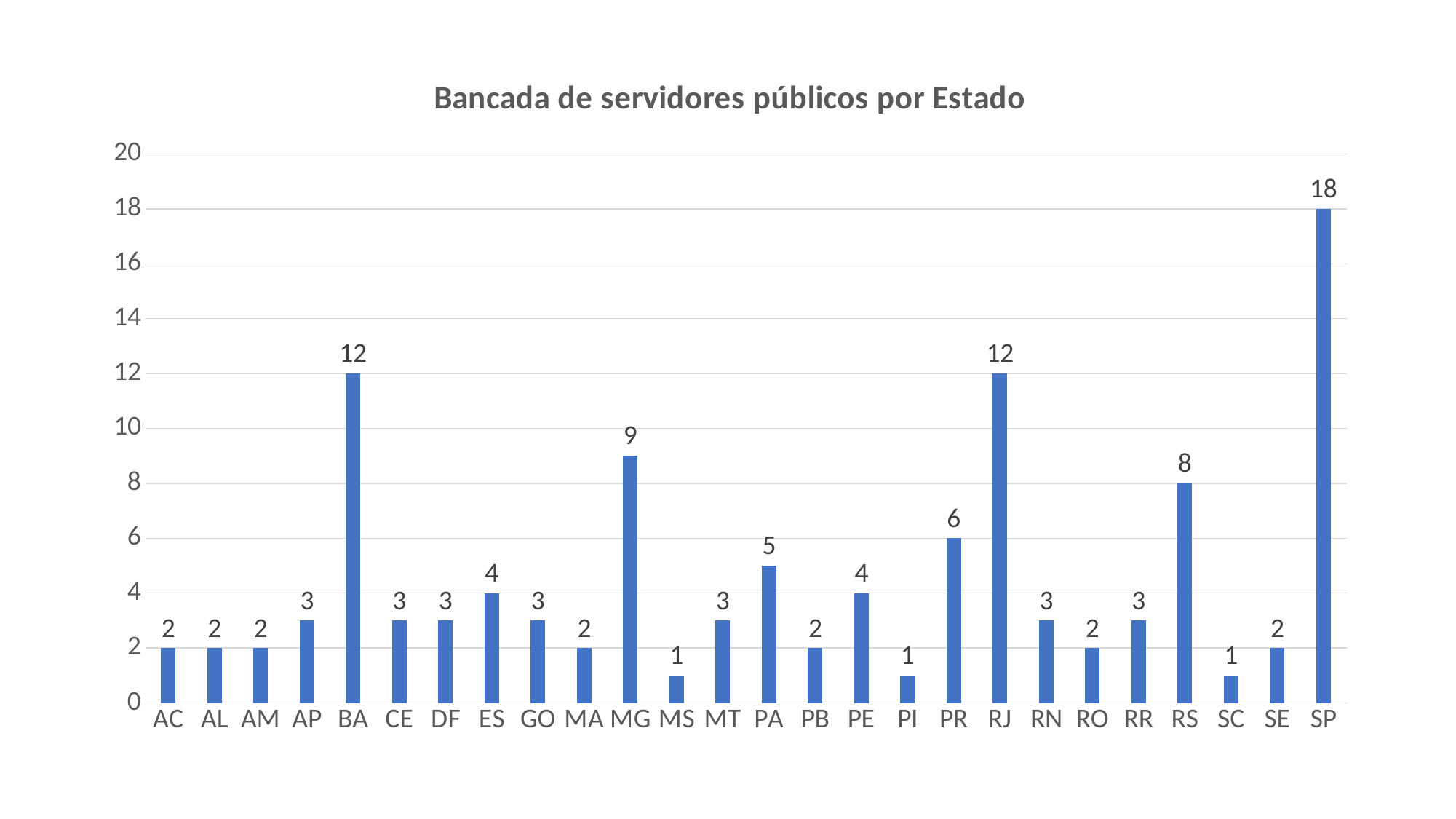
What is the value for PA? 5 What is the value for MG? 9 What is the value for RS? 8 Which has a larger value, RS or MG? MG Which state has the highest value? SP What is the difference between the values for SP and RJ? 6 What is the difference between the values for BA and MG? 3 What is the title of the chart? Bancada de servidores públicos por Estado What is the value for SP? 18 What kind of chart is this? Bar chart How many states are shown on the x axis? 26 Which has a larger value, PR or PE? PR